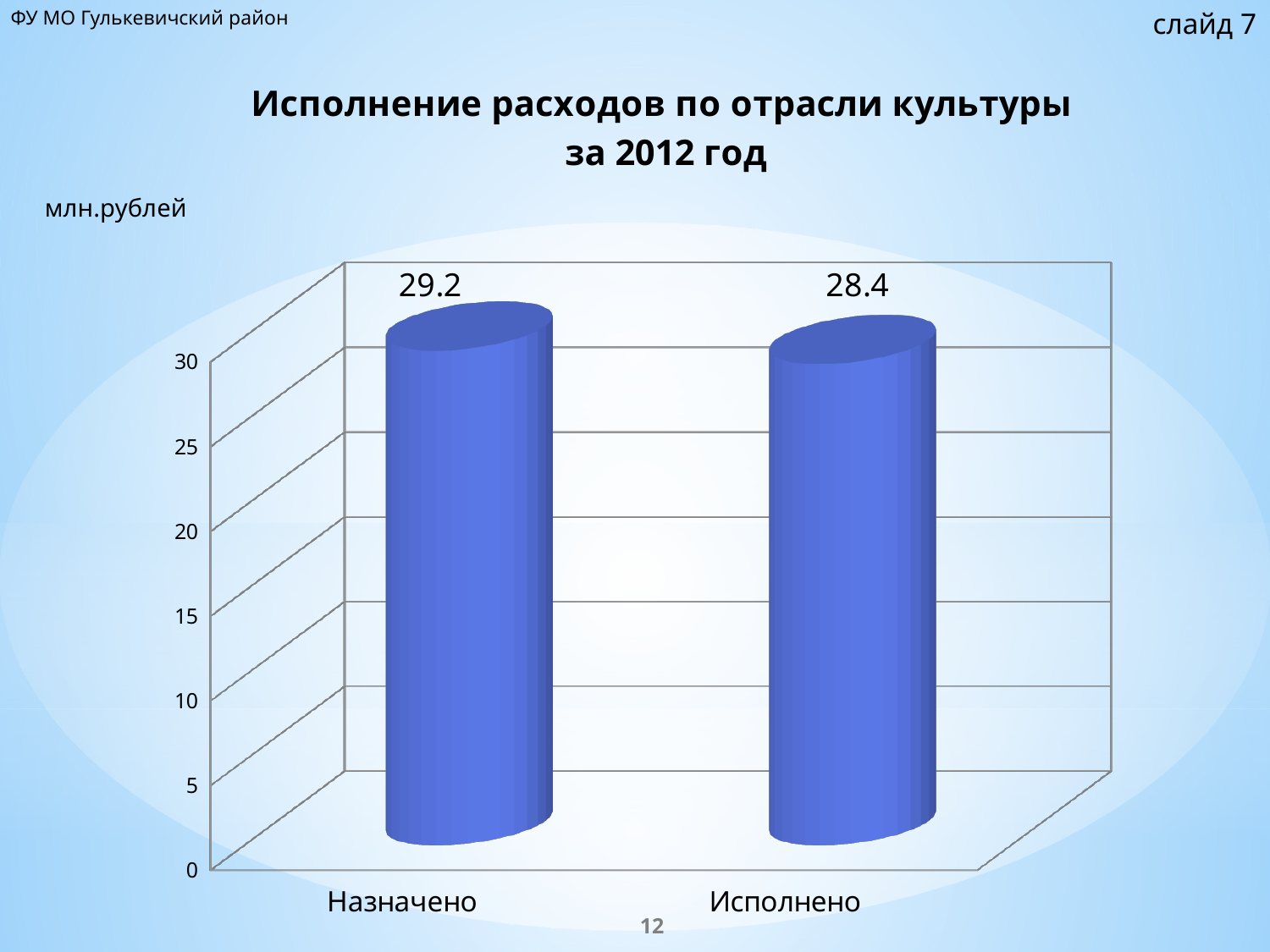
Is the value for Назначено greater or less than 30? less What is the value for Назначено? 29.2 Is the value for Исполнено greater or less than 25? greater What kind of chart is shown on the slide? bar chart What unit is indicated for the values on the chart? млн.рублей Which category has the highest value? Назначено What is the value for Исполнено? 28.4 Which is larger, the value for Назначено or the value for Исполнено? Назначено How many categories are shown on the chart? 2 What is the difference between the values for Назначено and Исполнено? 0.8 Which category has the lowest value? Исполнено What is the title of the chart? Исполнение расходов по отрасли культуры за 2012 год